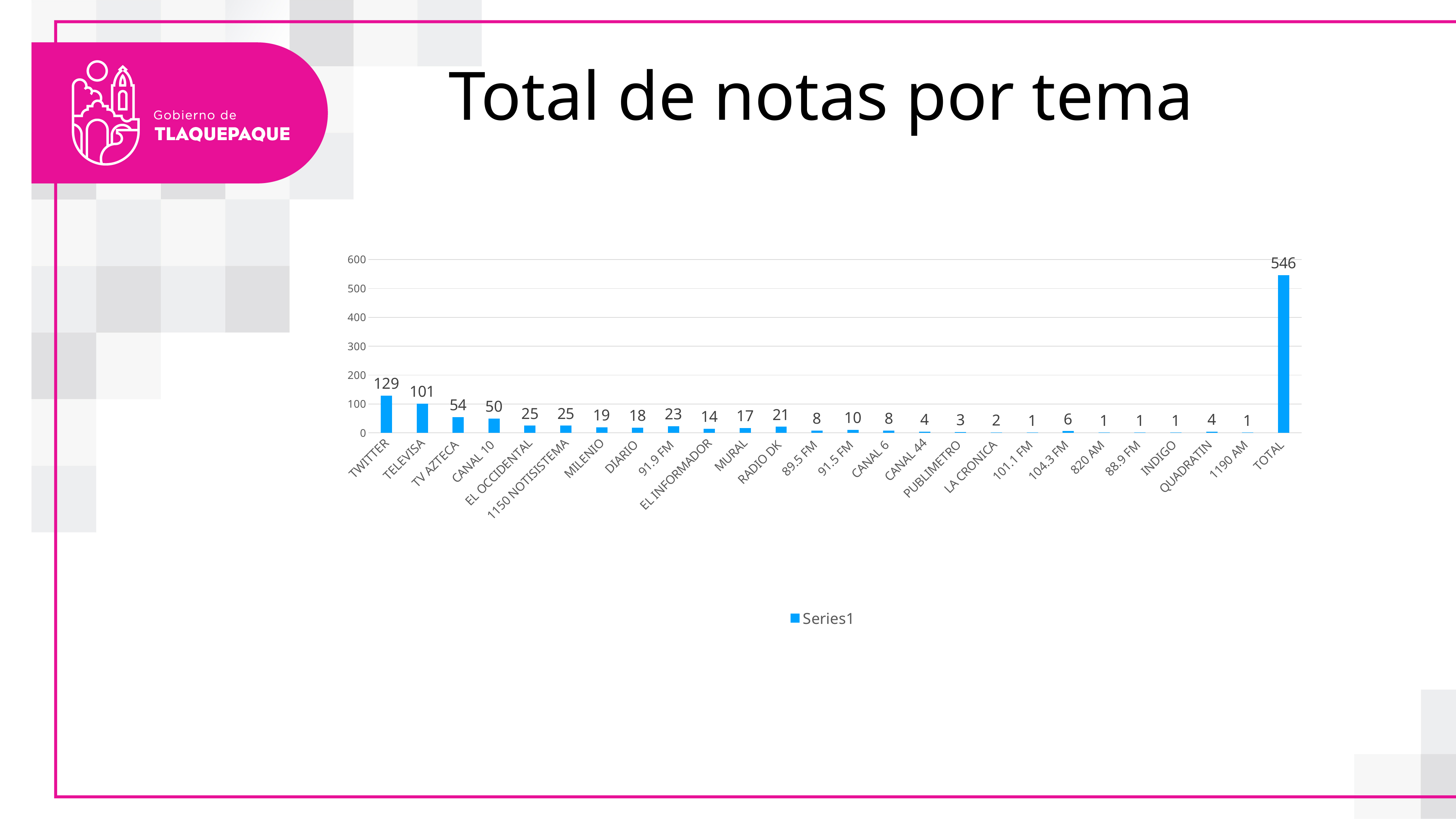
How many series does the legend list? 1 What is the value for the TOTAL bar? 546 Which is larger, the value for TV AZTECA or the value for CANAL 10? TV AZTECA Which category has the highest value? TOTAL What is the difference between the values for TWITTER and TELEVISA? 28 What is the value for RADIO DK? 21 What kind of chart is shown on the slide? bar chart What is the value for TWITTER? 129 Is the value for TOTAL greater or less than 500? greater Excluding the TOTAL bar, which category has the highest value? TWITTER How many categories are shown on the x axis? 26 What is the value for TELEVISA? 101